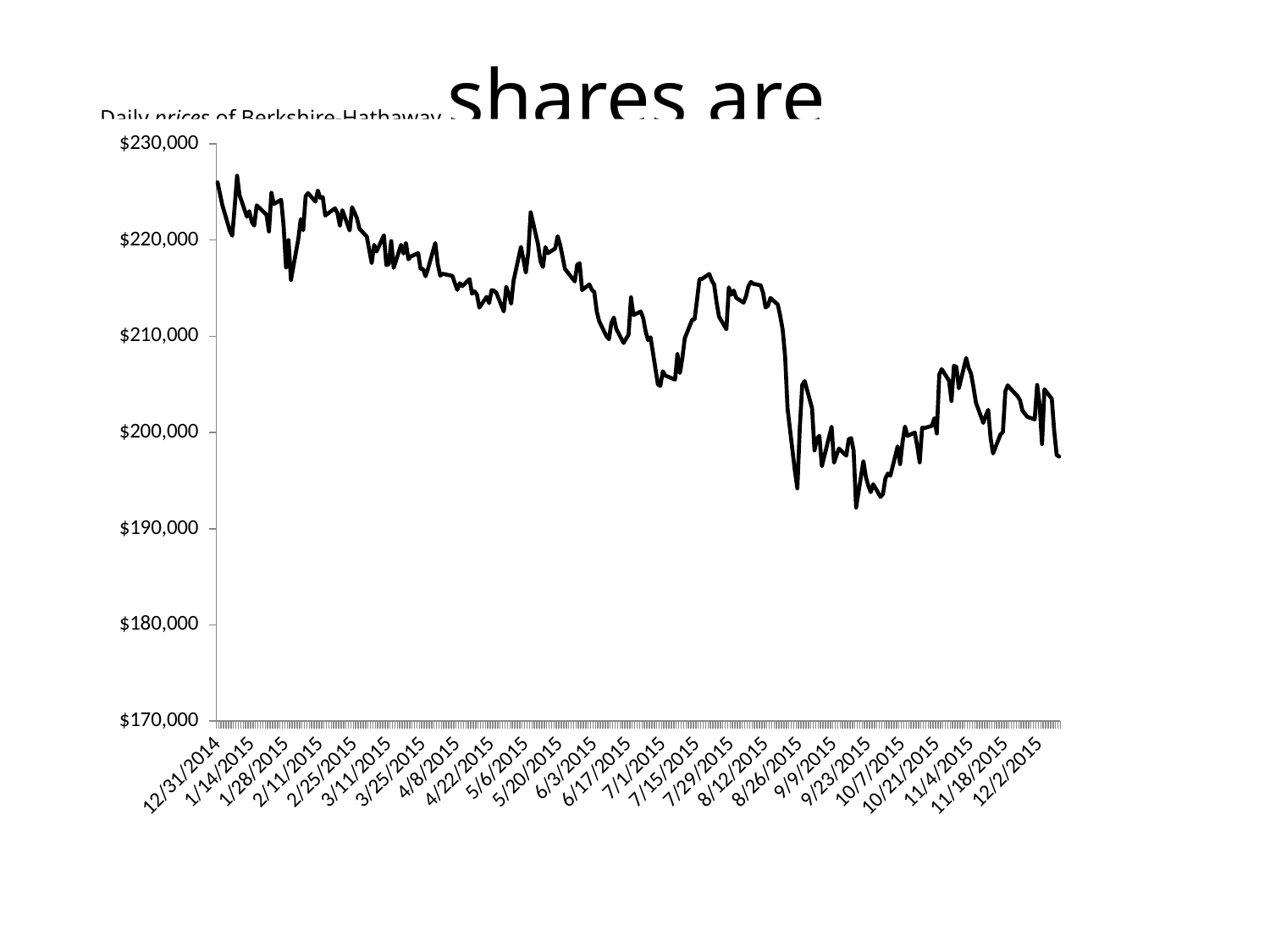
What is the lowest value shown on the y axis? $170,000 What kind of chart is shown on the slide? line chart Is the share price around 4/22/2015 greater or less than $220,000? less Overall, do the share prices rise or fall from 12/31/2014 to 12/2/2015? fall Is the share price around 9/23/2015 greater or less than $200,000? less Is the share price around 8/12/2015 greater or less than $210,000? greater Is the share price at the start of the series (12/31/2014) higher or lower than at the end (12/2/2015)? higher How many lines (data series) are plotted on the chart? 1 What is the highest value shown on the y axis? $230,000 How many date labels are shown along the x axis? 25